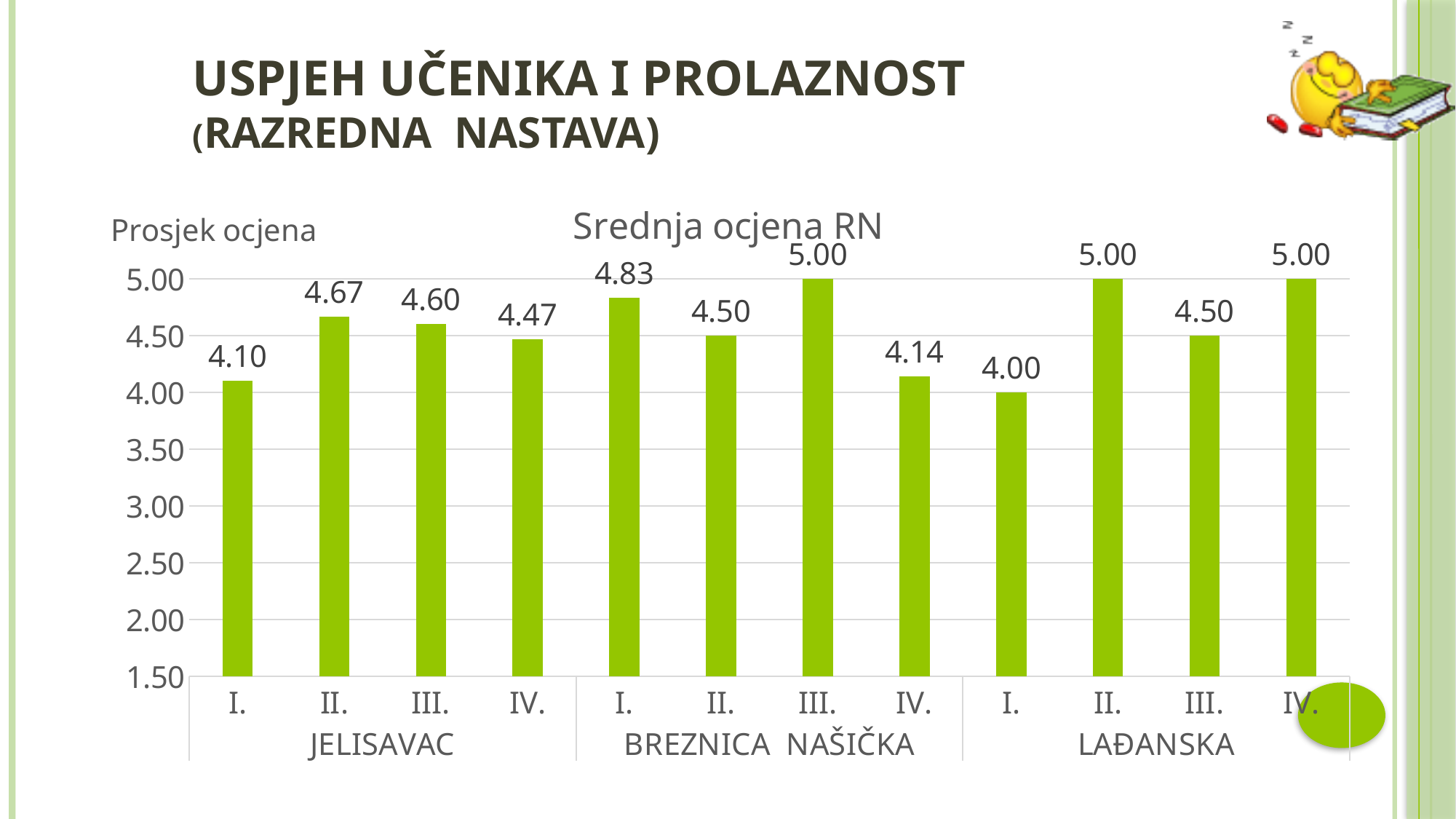
Which class at JELISAVAC has the lowest value? I. What is the value for class III. at LAĐANSKA? 4.50 What is the difference between class II. and class I. at JELISAVAC? 0.57 Which class at BREZNICA NAŠIČKA has the highest value? III. What is the difference between class I. at BREZNICA NAŠIČKA and class I. at LAĐANSKA? 0.83 What is the title of the chart? Srednja ocjena RN How many bars are plotted in the chart? 12 What is the value for class I. at JELISAVAC? 4.10 Which is larger: class III. at JELISAVAC or class II. at BREZNICA NAŠIČKA? class III. at JELISAVAC What kind of chart is shown? bar chart What is the value for class IV. at BREZNICA NAŠIČKA? 4.14 What is the lowest value shown in the chart? 4.00